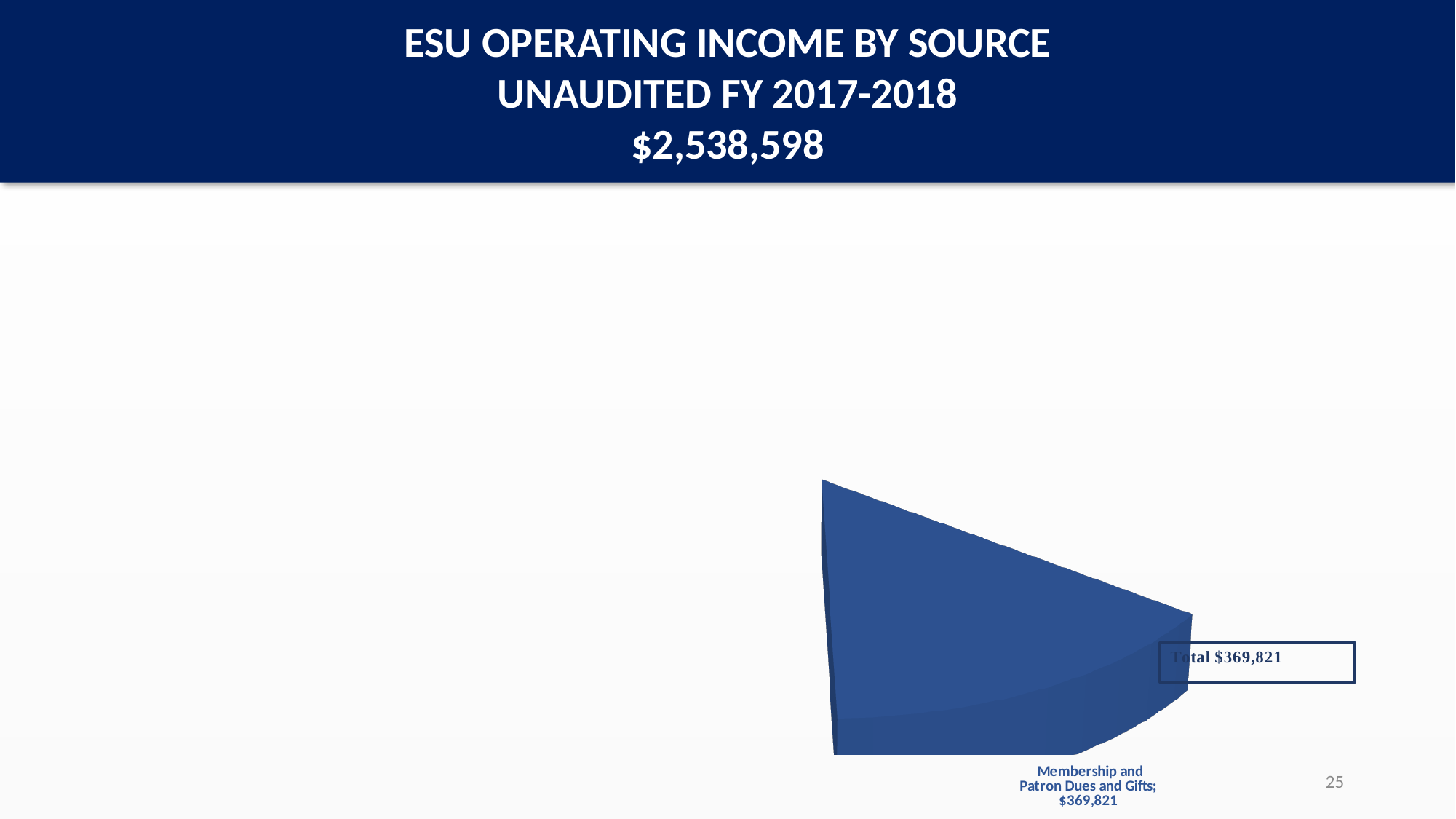
Which income source is labelled on the visible pie slice? Membership and Patron Dues and Gifts What total amount is shown in the text box next to the pie slice? Total $369,821 What fiscal year does the chart title say the operating income is for? FY 2017-2018 How many labelled slices are visible in the pie chart? 1 What kind of chart is shown on the slide? pie chart Is the value for Membership and Patron Dues and Gifts greater or less than $400,000? less Is the value for Membership and Patron Dues and Gifts greater or less than $300,000? greater What is the value shown for the Membership and Patron Dues and Gifts slice? $369,821